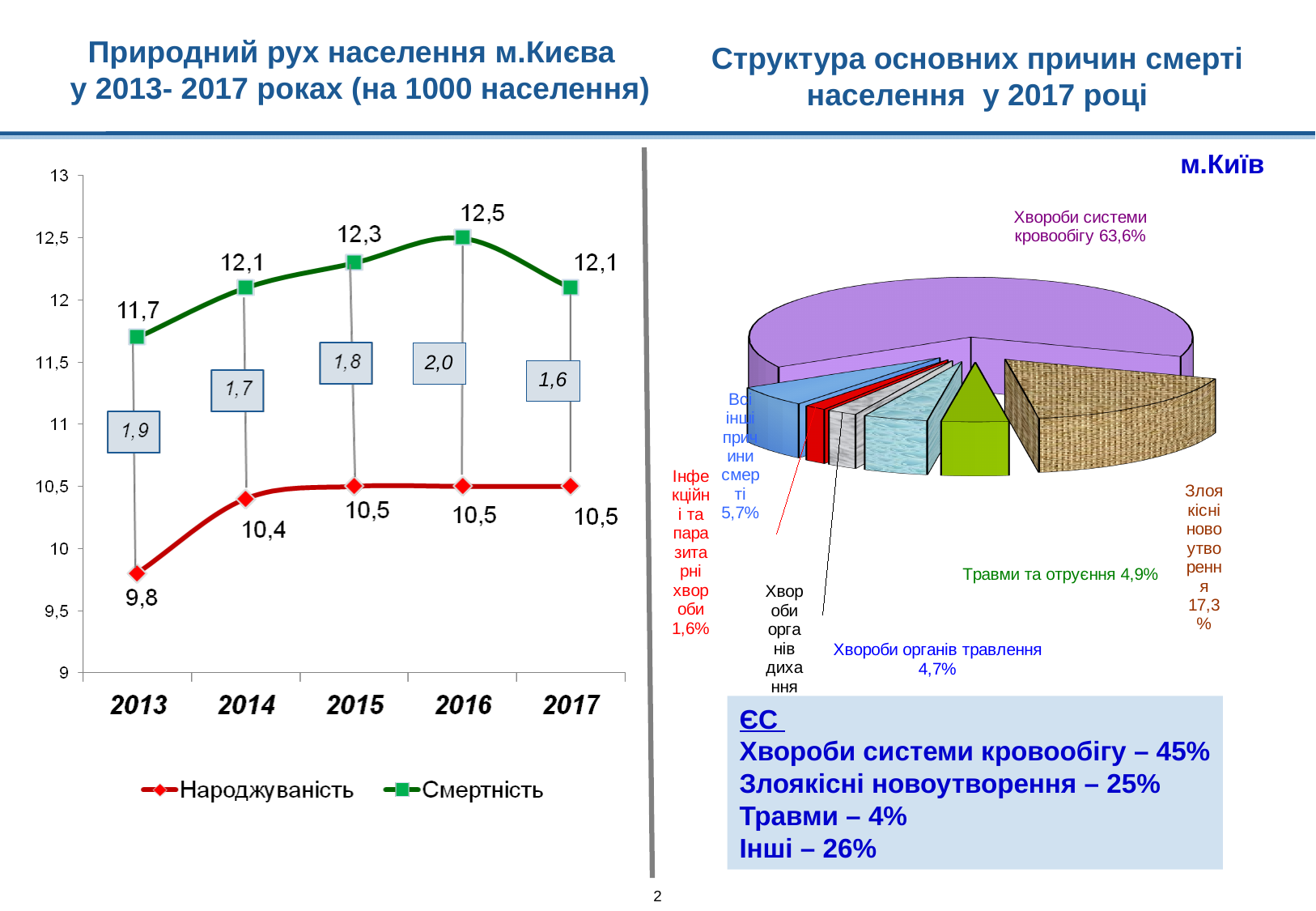
In the right chart (Структура основних причин смерті населення у 2017 році), what share is Хвороби системи кровообігу? 63,6% In the left chart (Природний рух населення м.Києва), what is the value of Смертність in 2016? 12,5 What kind of chart is the left chart (Природний рух населення м.Києва)? line chart In the right chart (Структура основних причин смерті населення у 2017 році), which cause has the largest share? Хвороби системи кровообігу In the left chart (Природний рух населення м.Києва), in which year is Смертність highest? 2016 In the left chart (Природний рух населення м.Києва), in which year is Народжуваність lowest? 2013 In the left chart (Природний рух населення м.Києва), how many series does the legend list? 2 In the left chart (Природний рух населення м.Києва), what is the value of Народжуваність in 2013? 9,8 In the left chart (Природний рух населення м.Києва), does Народжуваність rise or fall from 2013 to 2015? rise In the right chart (Структура основних причин смерті населення у 2017 році), which is larger: Травми та отруєння or Хвороби органів травлення? Травми та отруєння In the left chart (Природний рух населення м.Києва), how many years are shown on the x axis? 5 In the left chart (Природний рух населення м.Києва), what is the difference between Смертність and Народжуваність in 2014? 1,7